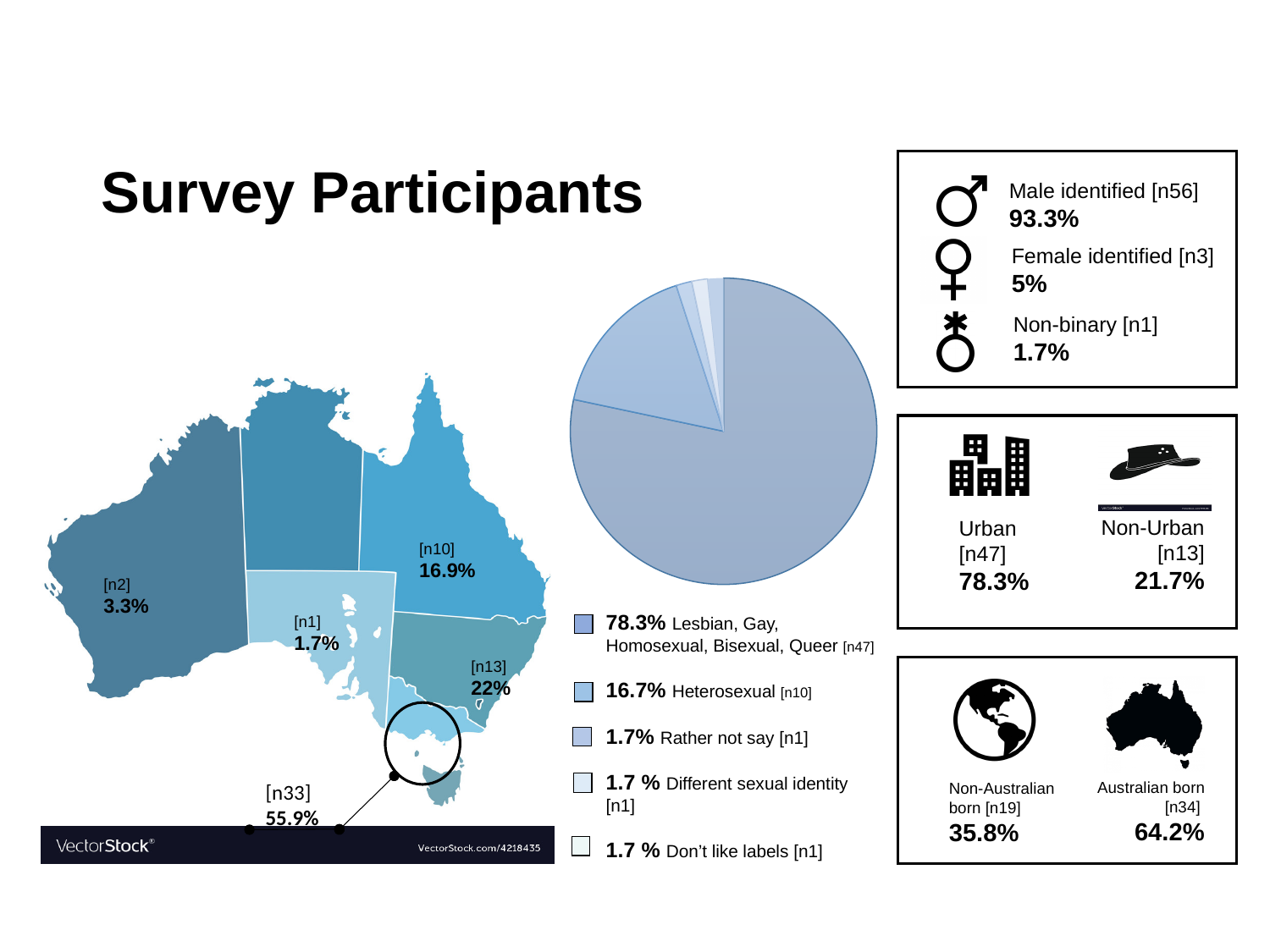
In the pie chart, how many categories each account for 1.7% of participants? 3 In the pie chart, which is larger: the Heterosexual slice or the 'Don't like labels' slice? Heterosexual How many categories does the pie chart's legend list? 5 In the pie chart, what share of participants chose 'Rather not say'? 1.7% In the pie chart, what share of participants identified as Lesbian, Gay, Homosexual, Bisexual, Queer? 78.3% In the pie chart, how many participants (n) are in the Lesbian, Gay, Homosexual, Bisexual, Queer category? 47 What is the title of the slide containing the pie chart? Survey Participants In the pie chart, which category has the largest slice? Lesbian, Gay, Homosexual, Bisexual, Queer In the pie chart, what share of participants identified as Heterosexual? 16.7% What kind of chart is shown in the centre of the slide? pie chart In the pie chart, how many participants (n) are in the Heterosexual category? 10 In the pie chart, what is the difference in percentage points between the Lesbian, Gay, Homosexual, Bisexual, Queer slice and the Heterosexual slice? 61.6